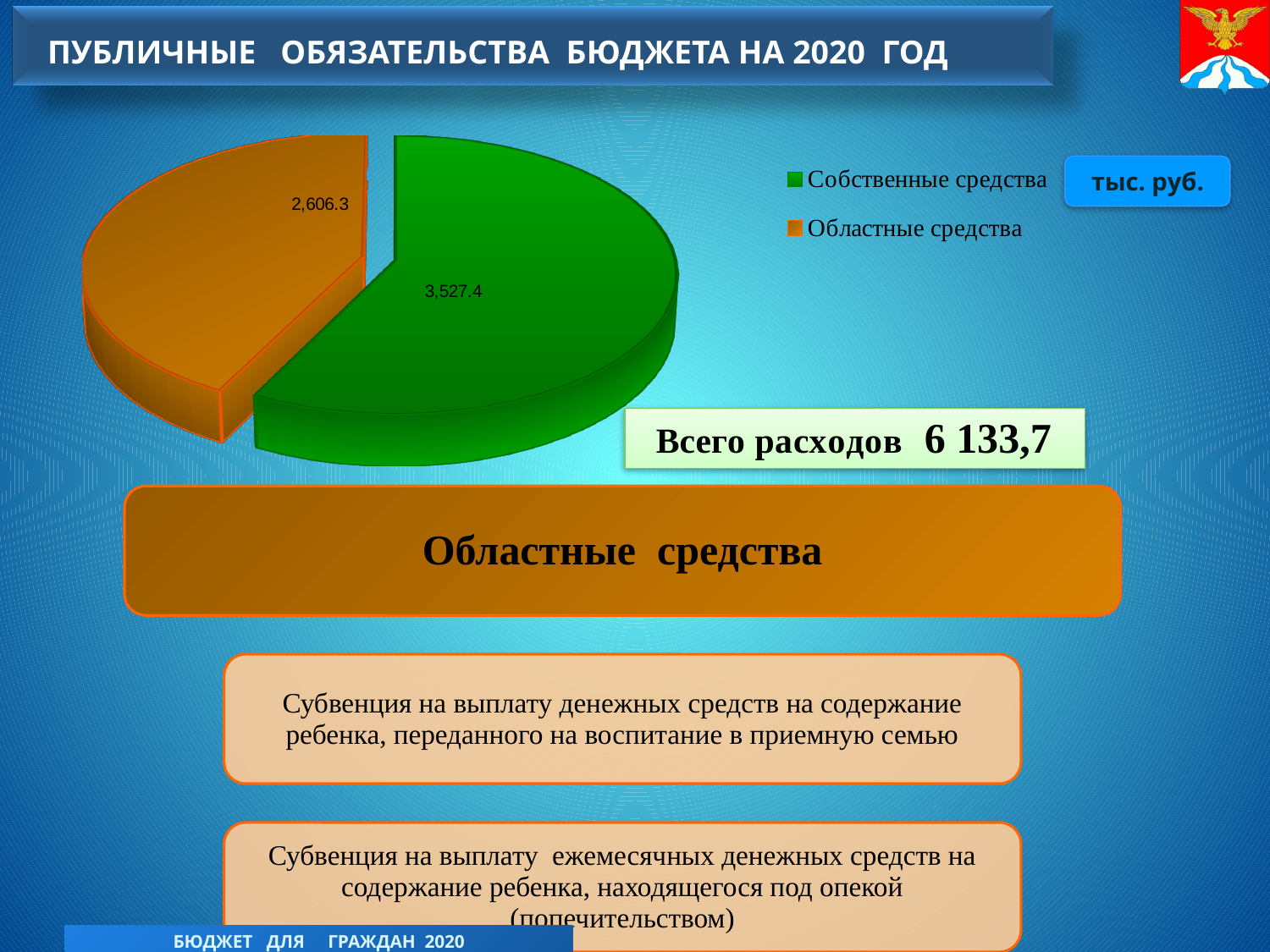
What share of the pie chart does Собственные средства represent? 57.5% How many slices does the pie chart have? 2 Which slice of the pie chart is the smallest? Областные средства What is the value for Собственные средства in the pie chart? 3,527.4 What is the value for Областные средства in the pie chart? 2,606.3 What is the difference between the values for Собственные средства and Областные средства in the pie chart? 921.1 What colour is the Областные средства slice in the pie chart? Orange Which is larger in the pie chart: Собственные средства or Областные средства? Собственные средства What is the total of the two slices in the pie chart? 6,133.7 Which slice of the pie chart is the largest? Собственные средства What share of the pie chart does Областные средства represent? 42.5% What type of chart is shown on the slide? Pie chart